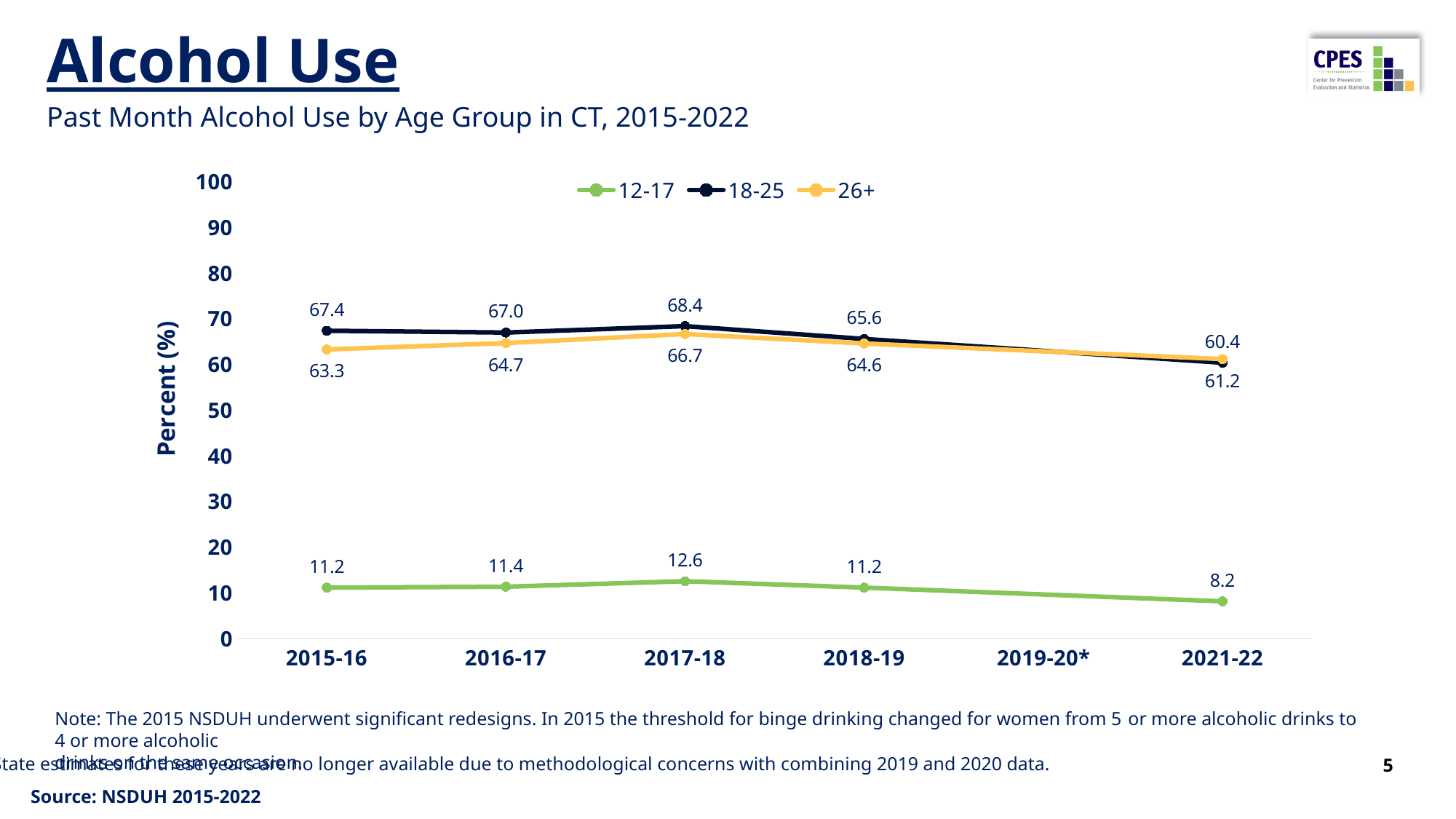
What is the label on the y axis of the chart? Percent (%) Does the 12-17 age group's value rise or fall from 2018-19 to 2021-22? Fall In which period does the 12-17 age group reach its highest value? 2017-18 What is the value for the 26+ age group in 2015-16? 63.3 What is the value for the 26+ age group in 2018-19? 64.6 What is the difference between the 18-25 and 26+ values in 2015-16? 4.1 What kind of chart is shown on the slide? Line chart What is the value for the 12-17 age group in 2021-22? 8.2 What is the value for the 18-25 age group in 2017-18? 68.4 In 2021-22, which age group has the higher value, 18-25 or 26+? 26+ How many series does the legend list? 3 In which period does the 18-25 age group have its lowest value? 2021-22